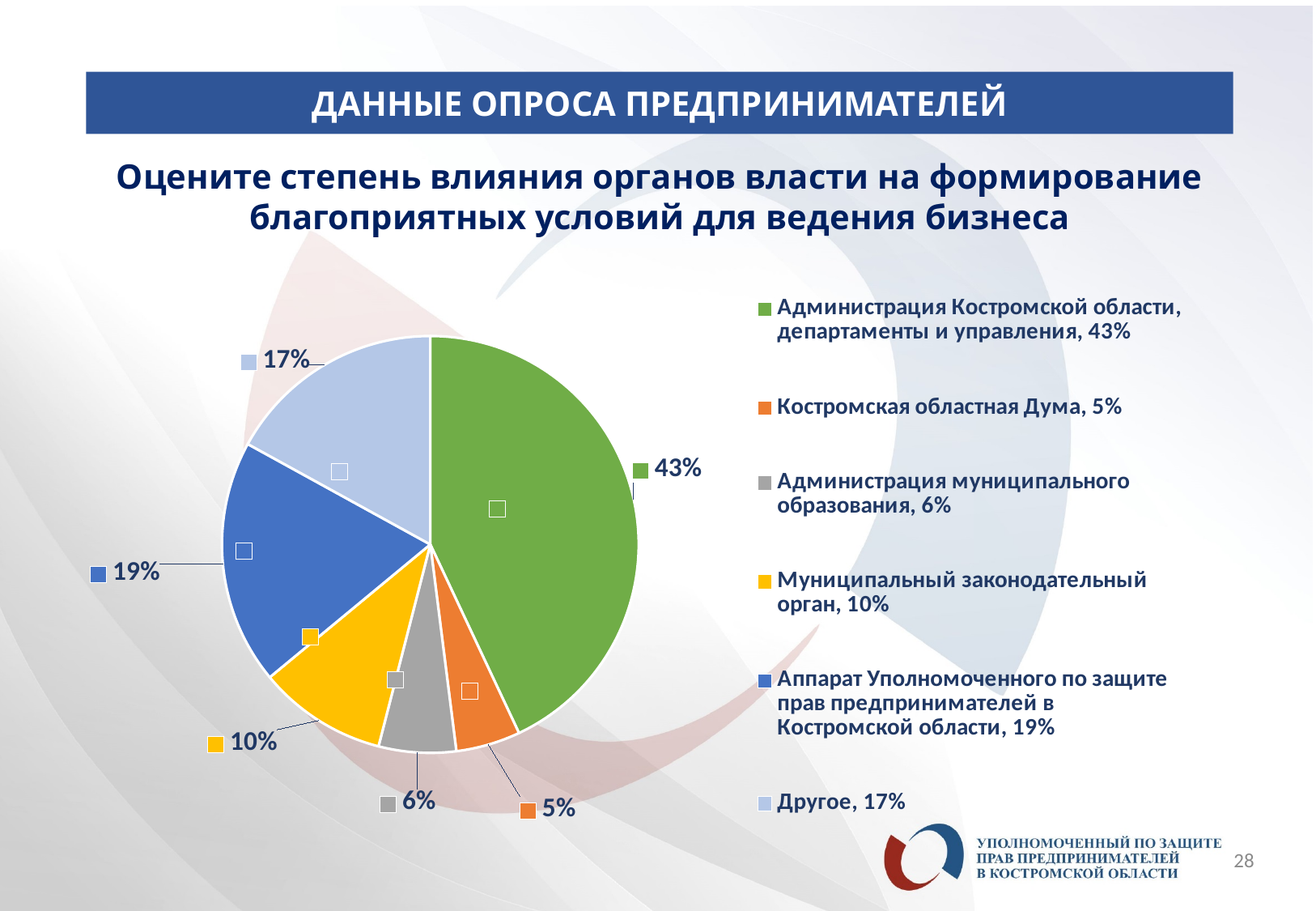
What share of the pie is labelled "Администрация Костромской области, департаменты и управления"? 43% What share of the pie is labelled "Костромская областная Дума"? 5% What share of the pie is labelled "Аппарат Уполномоченного по защите прав предпринимателей в Костромской области"? 19% What is the difference in percentage points between "Аппарат Уполномоченного по защите прав предпринимателей в Костромской области" and "Другое"? 2 What share of the pie is labelled "Другое"? 17% What is the combined share of "Костромская областная Дума" and "Администрация муниципального образования"? 11% Which is larger: the slice for "Муниципальный законодательный орган" or the slice for "Администрация муниципального образования"? Муниципальный законодательный орган Which category has the largest slice of the pie? Администрация Костромской области, департаменты и управления How many slices does the pie chart have? 6 What kind of chart is shown on the slide? Pie chart Which category has the smallest slice of the pie? Костромская областная Дума What colour is the slice for "Администрация Костромской области, департаменты и управления"? Green